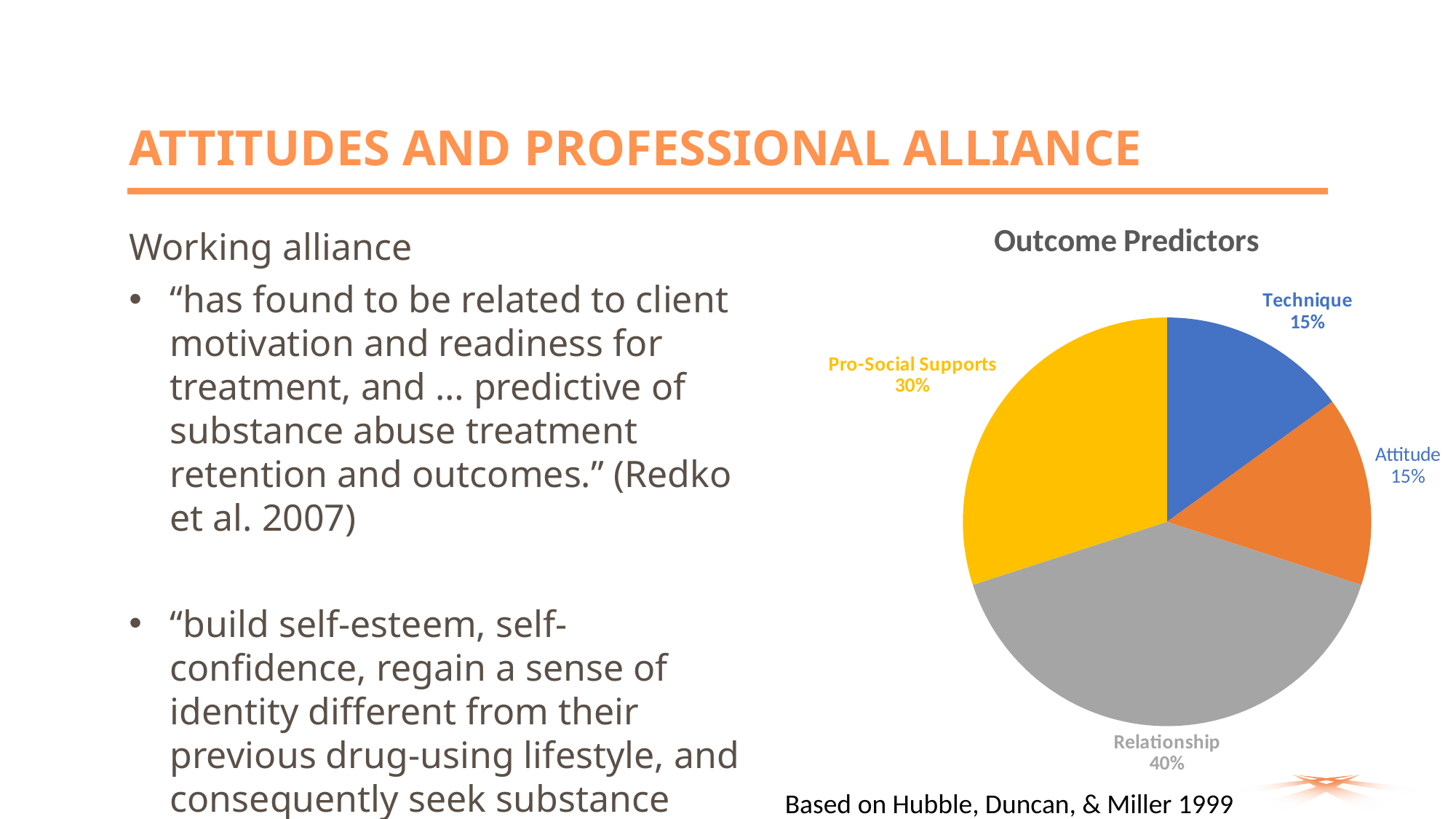
Which category has the largest slice of the pie? Relationship What share of the pie does Relationship account for? 40% What is the value for Attitude? 15% What is the difference between the Relationship and Pro-Social Supports values? 10% What is the combined share of Technique and Attitude? 30% What colour is the Relationship slice? grey What is the value for Pro-Social Supports? 30% Which is larger, Pro-Social Supports or Technique? Pro-Social Supports What is the title of the chart? Outcome Predictors How many slices does the pie chart have? 4 What kind of chart is shown on the slide? pie chart What is the value for Technique? 15%